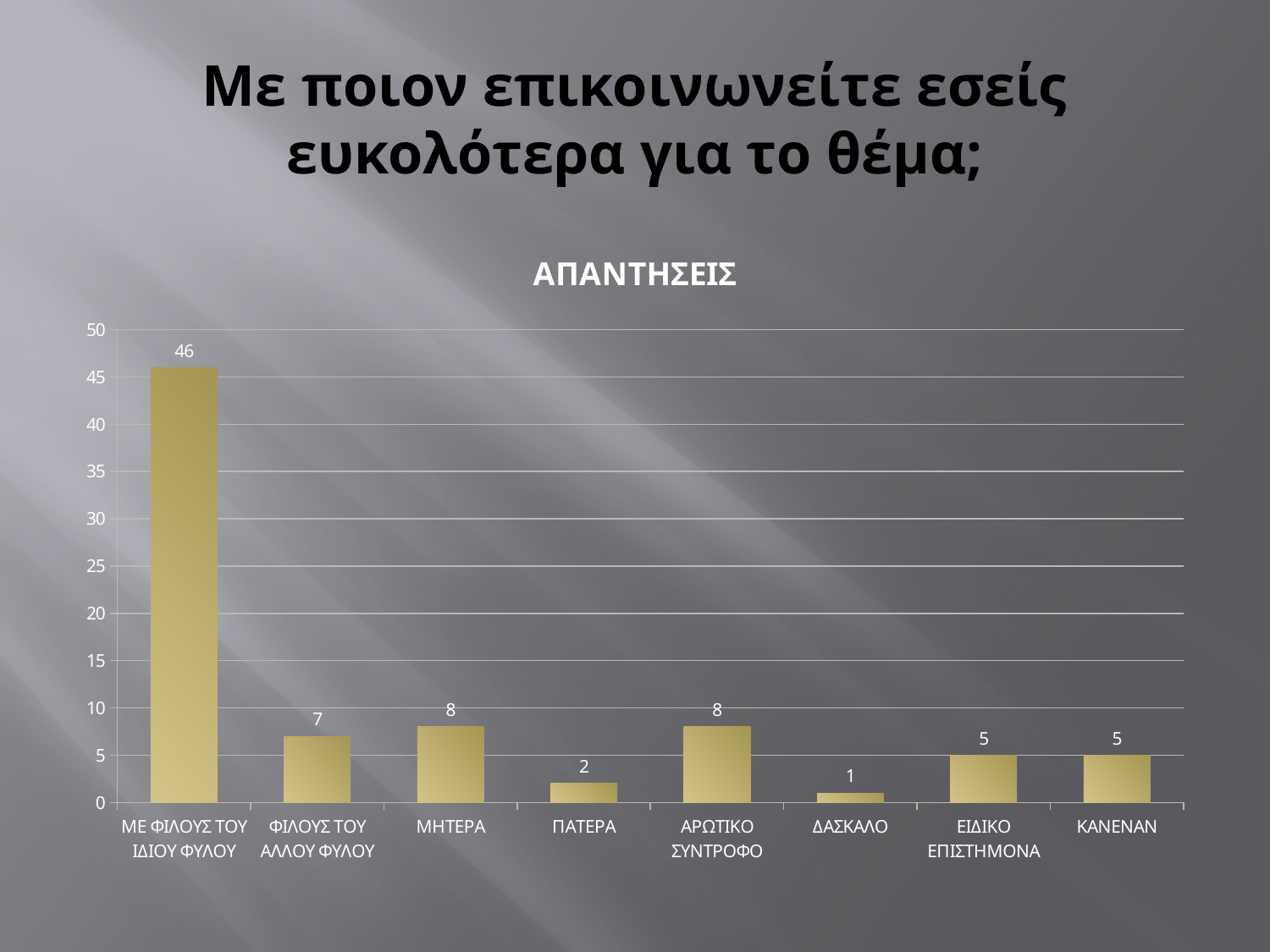
What is the value for ΜΗΤΕΡΑ? 8 Which category has the lowest value? ΔΑΣΚΑΛΟ What is the value for ΚΑΝΕΝΑΝ? 5 What kind of chart is shown on the slide? bar chart How many categories are shown on the x axis? 8 What is the value for ΠΑΤΕΡΑ? 2 Which category has the highest value? ΜΕ ΦΙΛΟΥΣ ΤΟΥ ΙΔΙΟΥ ΦΥΛΟΥ What is the title of the chart? ΑΠΑΝΤΗΣΕΙΣ Which is larger, the value for ΦΙΛΟΥΣ ΤΟΥ ΑΛΛΟΥ ΦΥΛΟΥ or the value for ΕΙΔΙΚΟ ΕΠΙΣΤΗΜΟΝΑ? ΦΙΛΟΥΣ ΤΟΥ ΑΛΛΟΥ ΦΥΛΟΥ Is the value for ΑΡΩΤΙΚΟ ΣΥΝΤΡΟΦΟ greater or less than 10? less What is the value for ΔΑΣΚΑΛΟ? 1 What is the difference between the values for ΜΕ ΦΙΛΟΥΣ ΤΟΥ ΙΔΙΟΥ ΦΥΛΟΥ and ΦΙΛΟΥΣ ΤΟΥ ΑΛΛΟΥ ΦΥΛΟΥ? 39